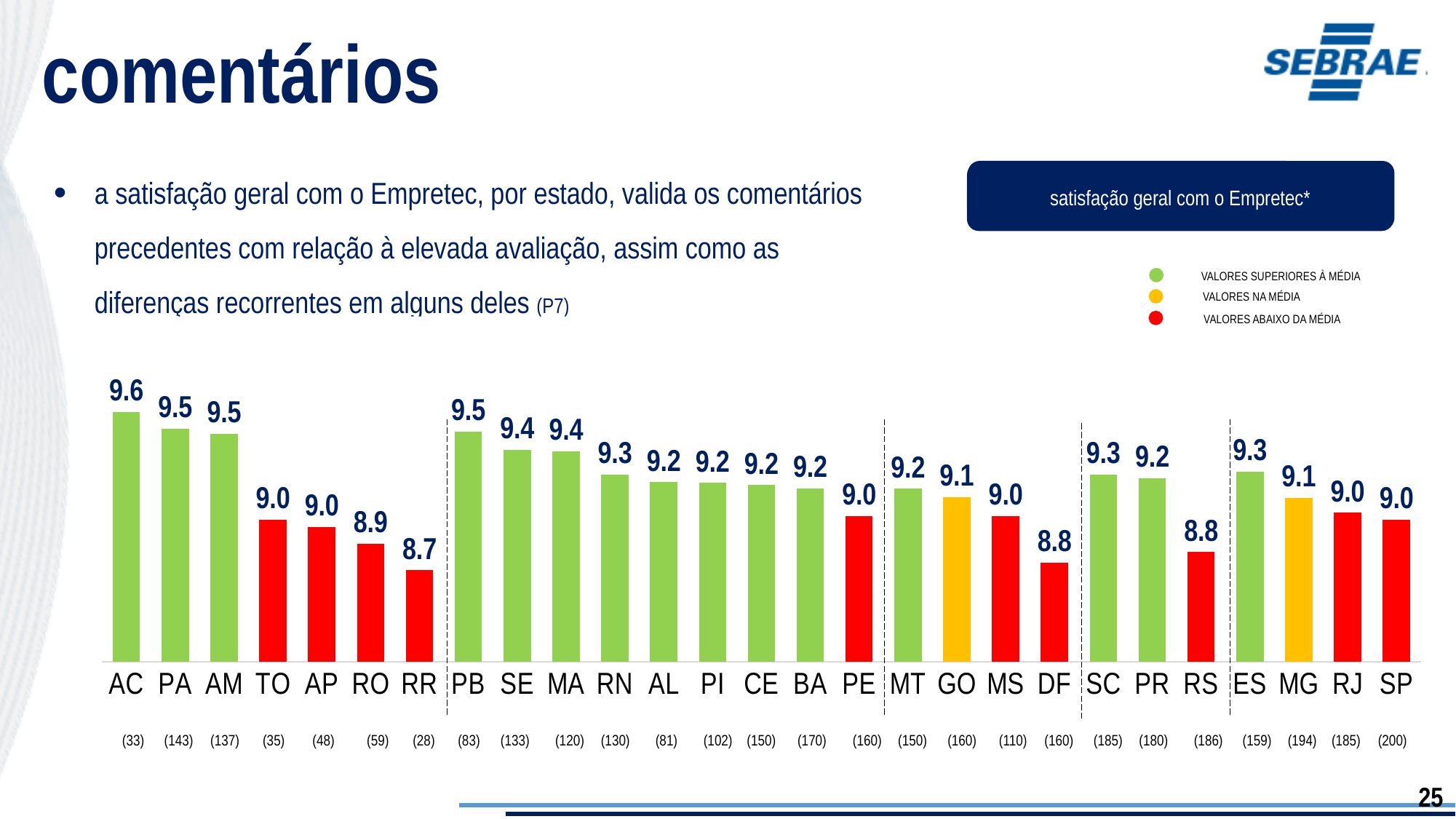
Which state has the highest value? AC What is the difference between the values for PB and PE? 0.5 How many states are shown on the chart? 27 Which is larger, the value for SE or the value for DF? SE Which is larger, the value for RO or the value for SC? SC What is the title of the chart? satisfação geral com o Empretec* What is the value for AC? 9.6 What is the value for RR? 8.7 Which state has the lowest value? RR What kind of chart is shown on the slide? bar chart What is the value for GO? 9.1 What is the difference between the values for AC and RR? 0.9